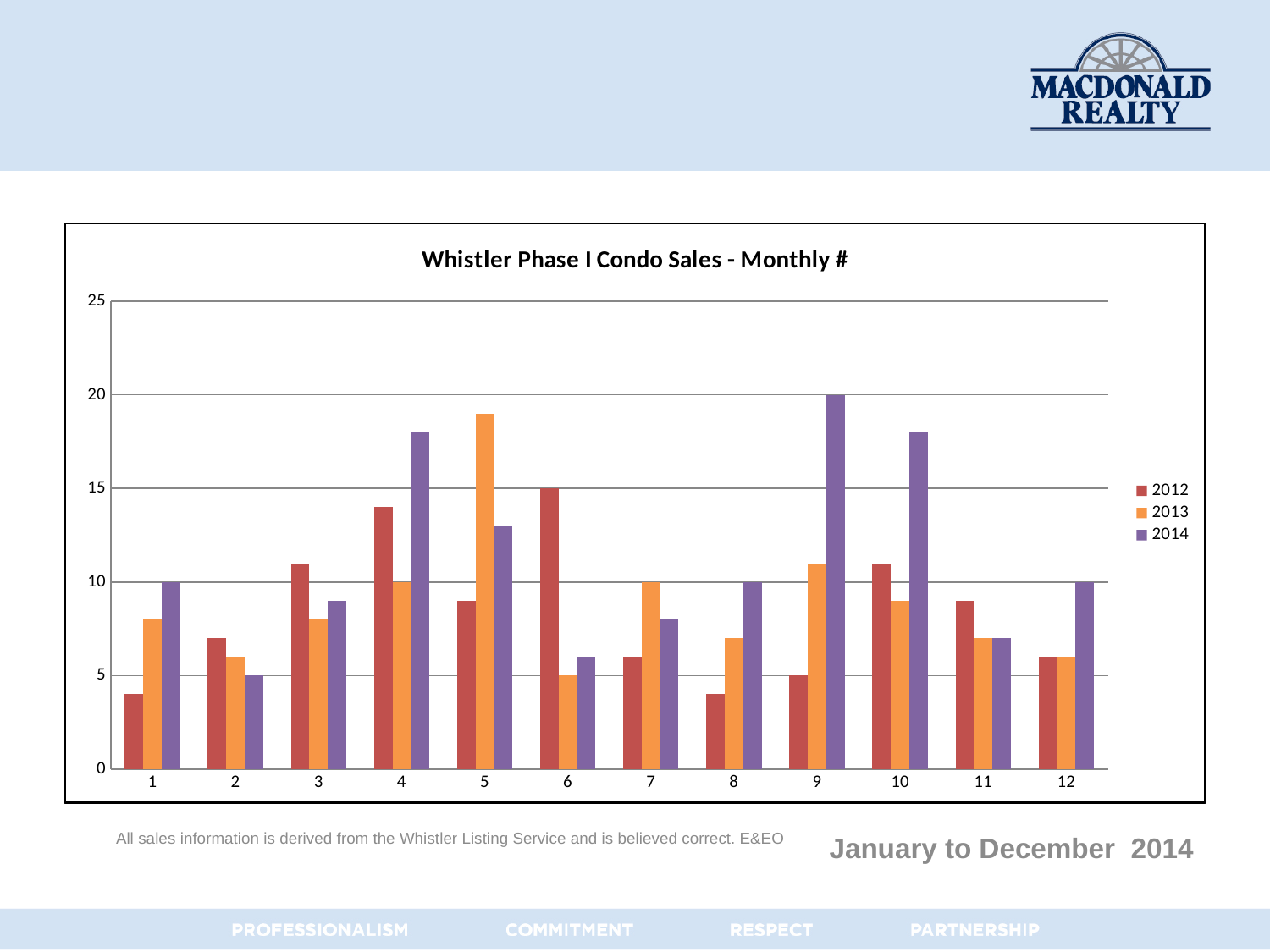
What is the value for 2014 in month 9? 20 What is the title of the chart? Whistler Phase I Condo Sales - Monthly # What is the value for 2012 in month 6? 15 How many series does the legend list? 3 Is the value for 2012 in month 1 greater or less than 5? less How many months (categories) are shown on the x axis? 12 Which month has the highest 2014 value? 9 What kind of chart is shown on the slide? bar chart What is the value for 2014 in month 1? 10 Is the value for 2013 in month 5 greater or less than 15? greater In month 5, which series has the larger value, 2012 or 2013? 2013 In month 6, which series has the larger value, 2012 or 2014? 2012